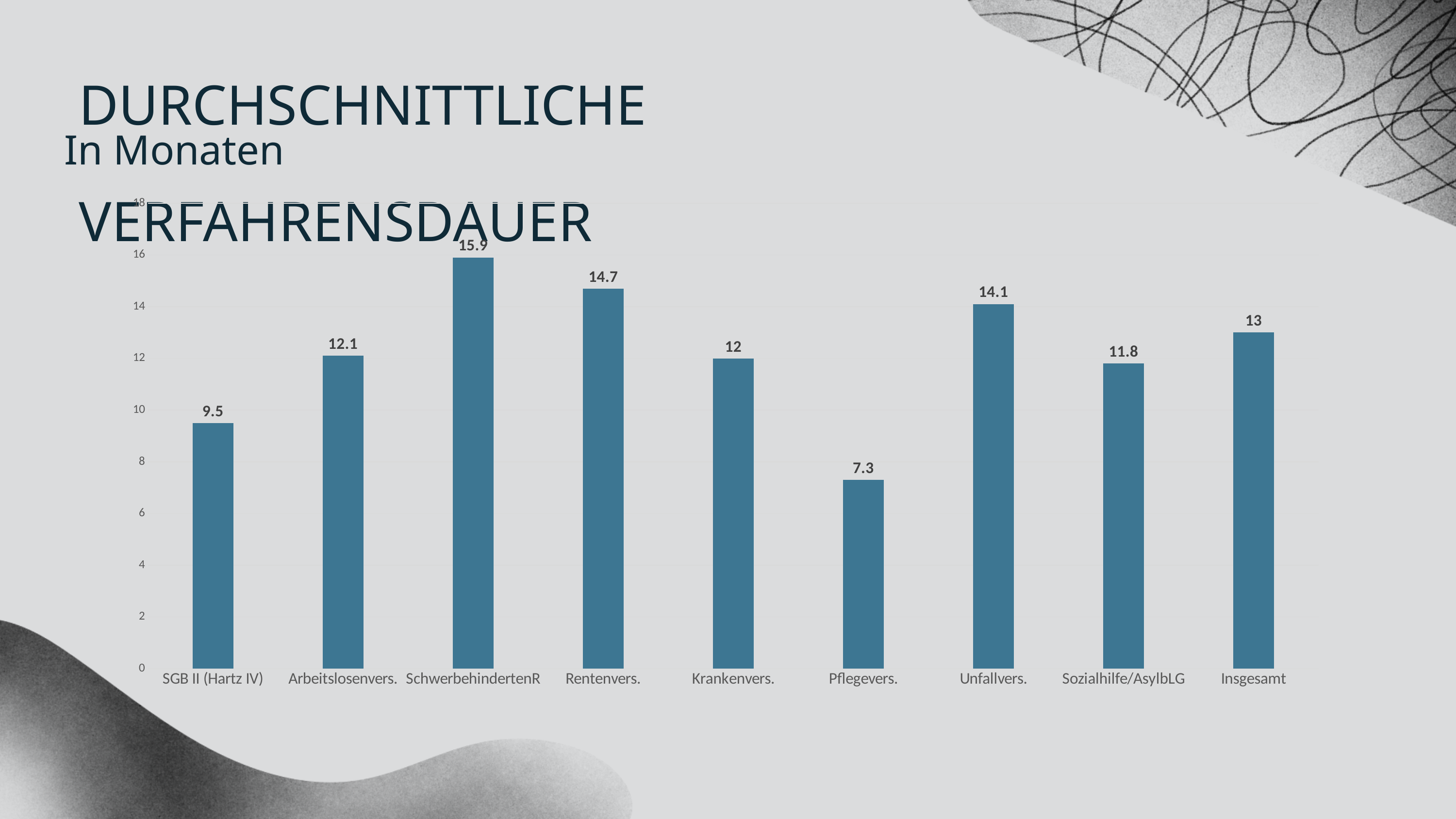
Which category has the lowest value? Pflegevers. What is the value for Pflegevers.? 7.3 What is the value for Insgesamt? 13 What is the value for Sozialhilfe/AsylbLG? 11.8 Which is larger, the value for Arbeitslosenvers. or the value for Krankenvers.? Arbeitslosenvers. How many categories are shown on the x axis? 9 Is the value for Unfallvers. greater or less than 12? greater What is the value for Rentenvers.? 14.7 What is the difference between the values for Unfallvers. and SGB II (Hartz IV)? 4.6 Which category has the highest value? SchwerbehindertenR What unit is stated in the subtitle of the chart? In Monaten What kind of chart is shown on the slide? bar chart